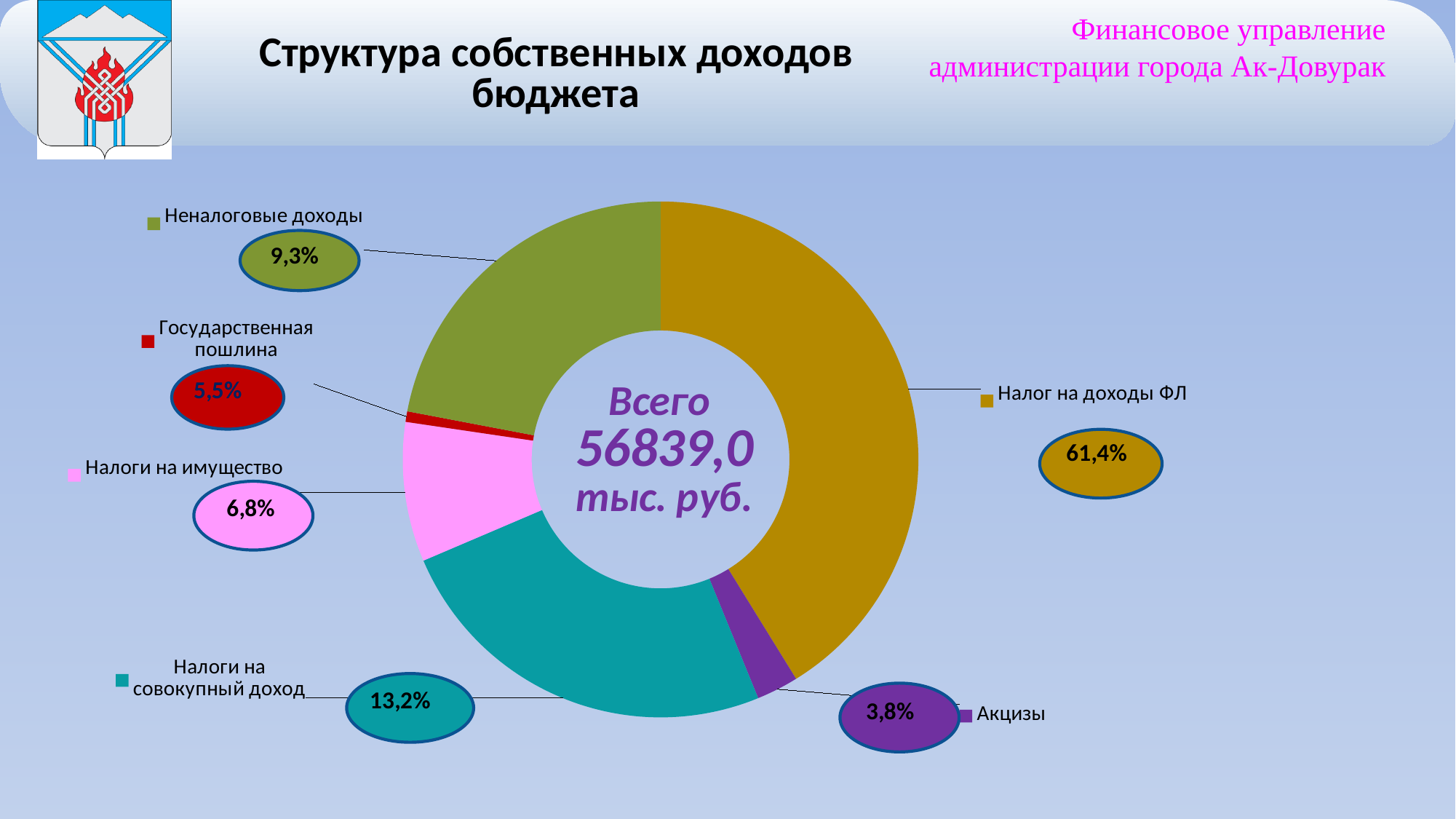
What percentage is shown for "Неналоговые доходы"? 9,3% What percentage is shown for "Акцизы"? 3,8% What total amount is shown in the centre of the chart? 56839,0 тыс. руб. Which category has the largest share of the budget's own revenues? Налог на доходы ФЛ What type of chart is shown on the slide? Doughnut chart How many categories are shown in the chart? 6 What colour represents "Налоги на совокупный доход" in the chart? Teal What percentage is shown for "Налоги на совокупный доход"? 13,2% What is the difference in percentage points between "Налоги на совокупный доход" and "Налоги на имущество"? 6,4 Which is larger: the share of "Государственная пошлина" or the share of "Налоги на имущество"? Налоги на имущество What share of own budget revenues does "Налог на доходы ФЛ" account for? 61,4%